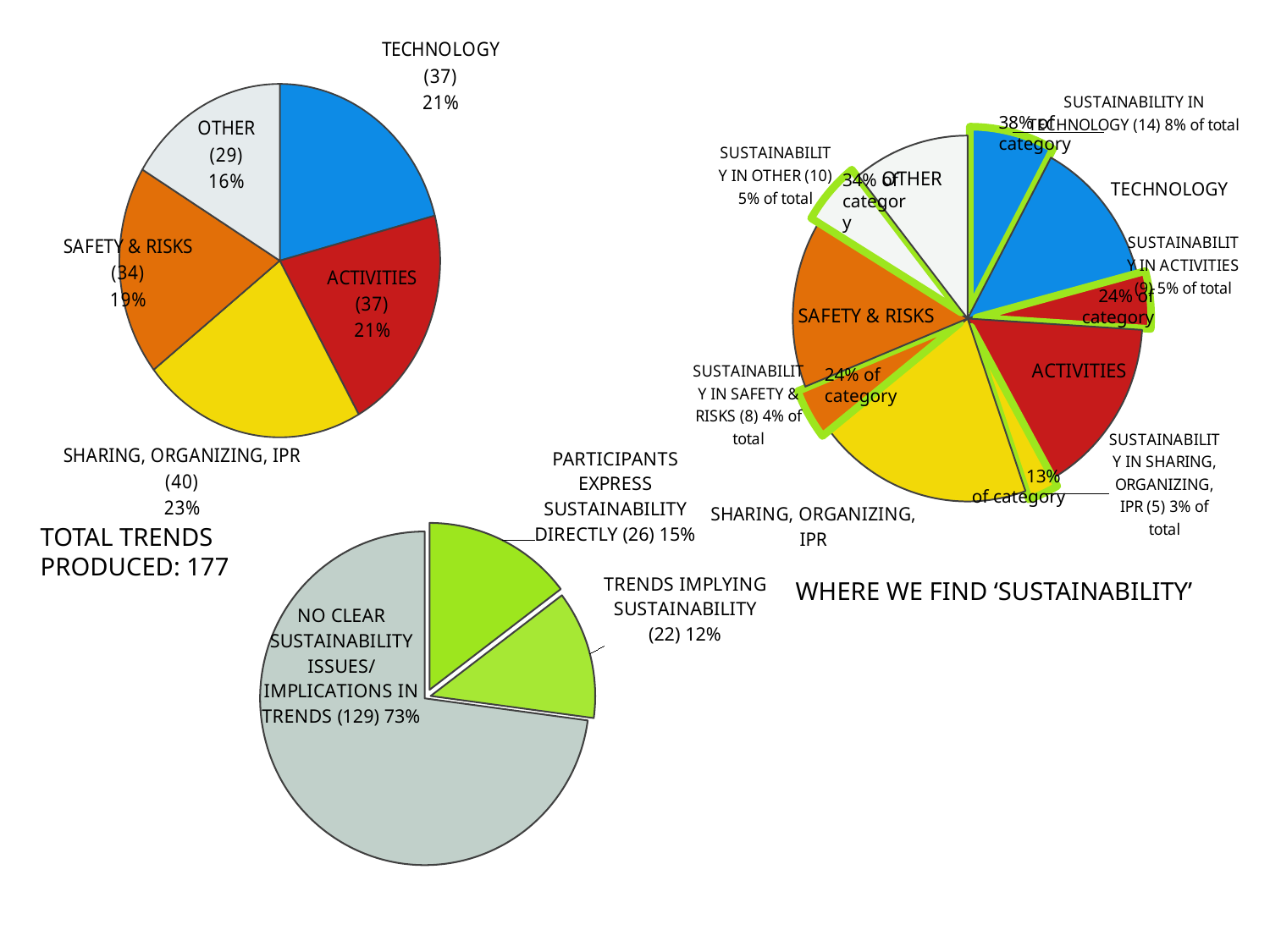
In the 'WHERE WE FIND SUSTAINABILITY' pie chart, how many trends are counted as SUSTAINABILITY IN TECHNOLOGY? 14 In the 'WHERE WE FIND SUSTAINABILITY' pie chart, what percentage of the total is SUSTAINABILITY IN SAFETY & RISKS? 4% of total What type of chart is used for the bottom-left chart? Pie chart In the top-left pie chart, which category has the largest number of trends? SHARING, ORGANIZING, IPR How many categories does the top-left pie chart show? 5 In the bottom-left pie chart, how many trends have no clear sustainability issues/implications? 129 In the bottom-left pie chart, which is larger: PARTICIPANTS EXPRESS SUSTAINABILITY DIRECTLY or TRENDS IMPLYING SUSTAINABILITY? PARTICIPANTS EXPRESS SUSTAINABILITY DIRECTLY In the top-left pie chart, what is the difference between the number of trends in SHARING, ORGANIZING, IPR and in SAFETY & RISKS? 6 In the top-left pie chart, how many trends are in the SHARING, ORGANIZING, IPR category? 40 In the bottom-left pie chart, what percentage of trends are ones where participants express sustainability directly? 15% In the top-left pie chart, which category has the smallest number of trends? OTHER In the top-left pie chart, what percentage share does OTHER have? 16%